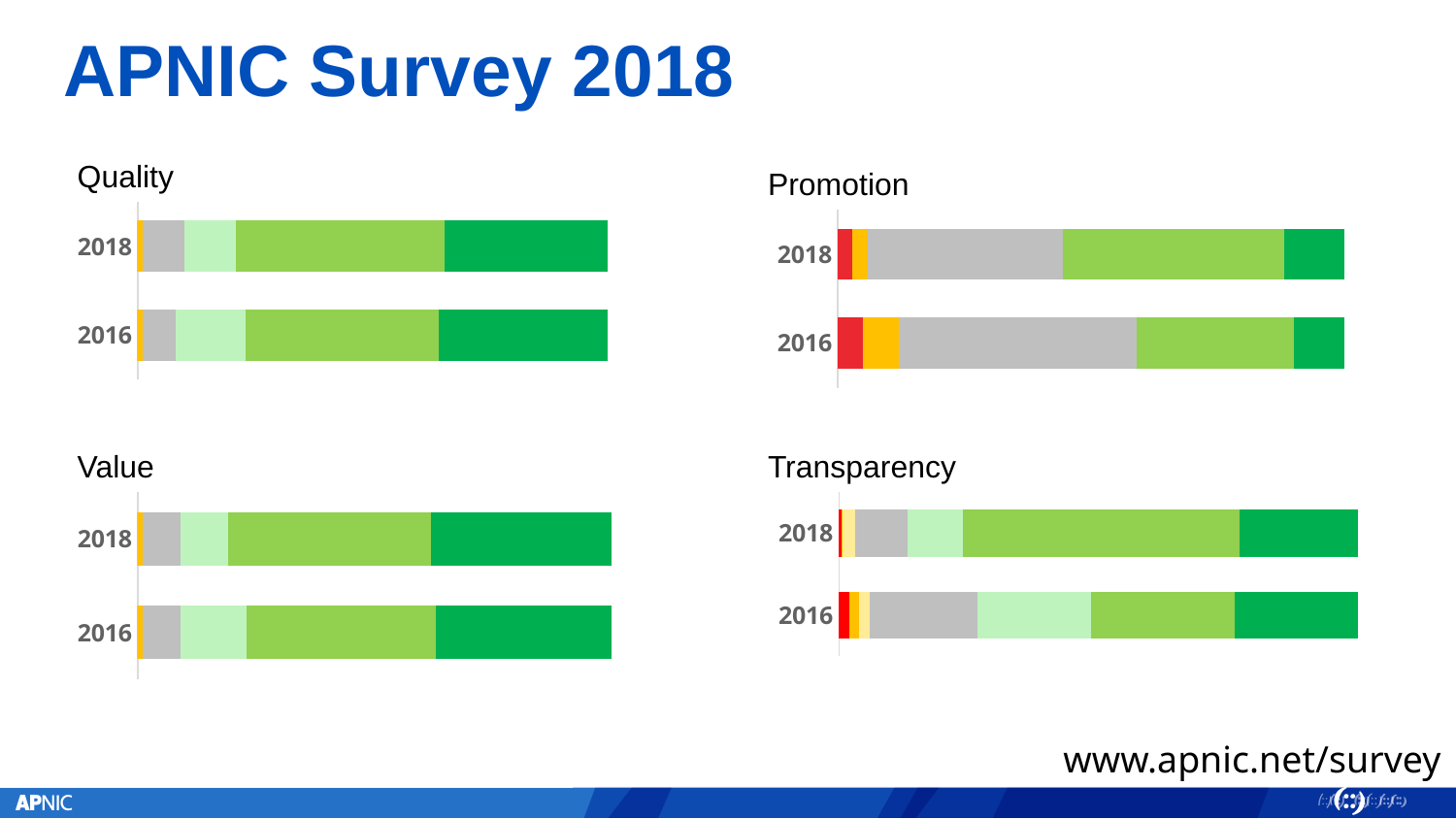
In the Promotion chart, is the light green segment larger in 2018 or 2016? 2018 In the Transparency chart, is the light green segment larger in 2018 or 2016? 2016 In the Promotion chart, is the grey segment larger in 2018 or 2016? 2016 Which of the four charts has the largest red segments? Promotion How many coloured segments make up the 2018 bar in the Promotion chart? 5 What are the titles of the four charts on the slide? Quality, Promotion, Value, Transparency What kind of chart is used for the Quality panel? stacked bar chart How many charts are shown on the slide? 4 How many bars does the Quality chart contain? 2 Which two years are compared in each chart? 2018 and 2016